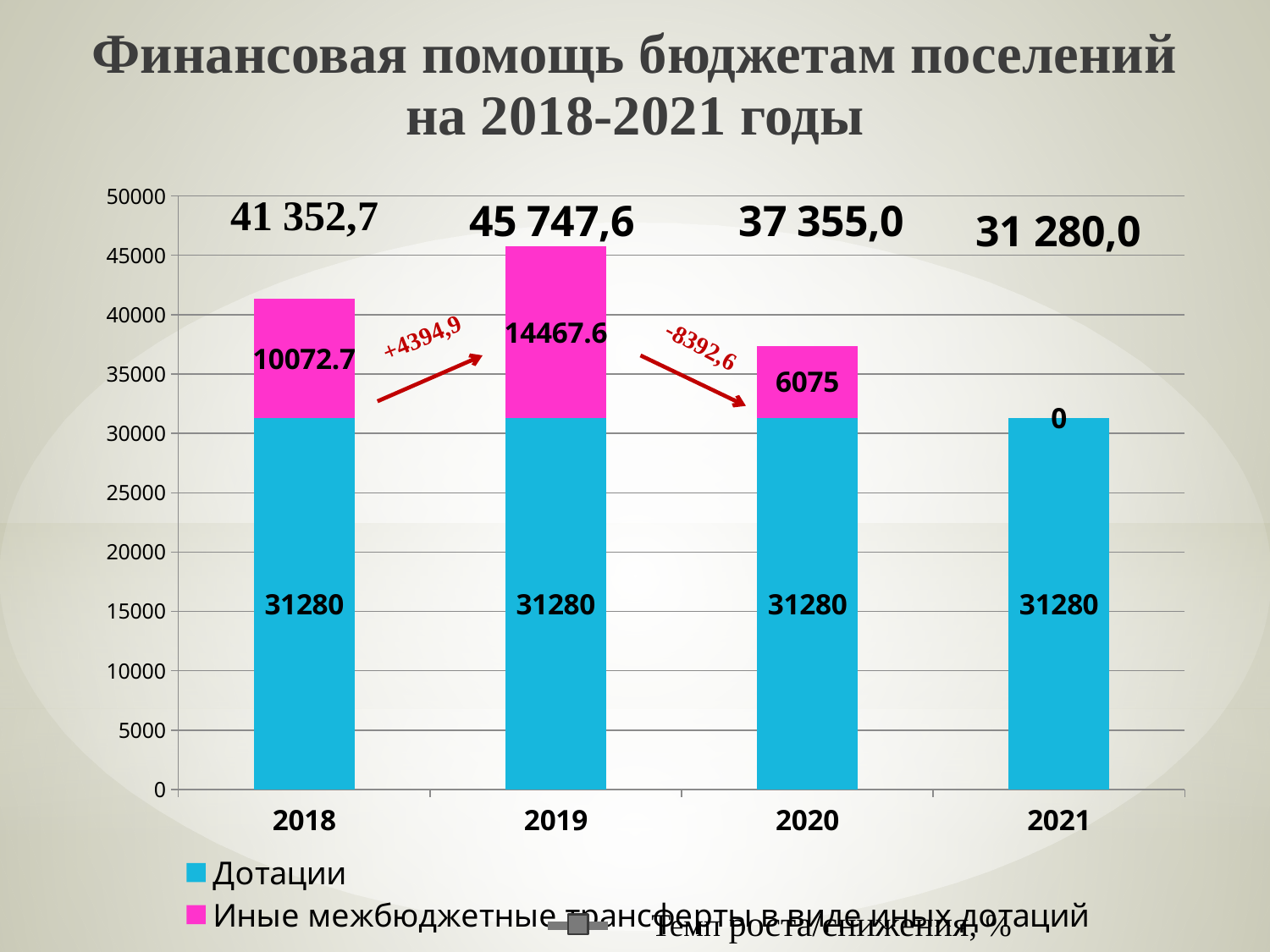
What is the value of Дотации for 2020? 31280 By how much is the Иные межбюджетные трансферты в виде иных дотаций value for 2020 lower than for 2019? 8392.6 What is the total of the stacked bar for 2018? 41 352,7 What is the value of Иные межбюджетные трансферты в виде иных дотаций for 2019? 14467.6 Which year has the lowest total financial assistance? 2021 Which year has the larger Иные межбюджетные трансферты в виде иных дотаций value, 2018 or 2020? 2018 Is the total for 2020 greater or less than 35000? greater What is the value of Иные межбюджетные трансферты в виде иных дотаций for 2021? 0 In which year is the Иные межбюджетные трансферты в виде иных дотаций value highest? 2019 By how much does the Иные межбюджетные трансферты в виде иных дотаций value for 2019 exceed that for 2018? 4394.9 How many years are shown on the x axis? 4 What kind of chart is shown on the slide? stacked bar chart